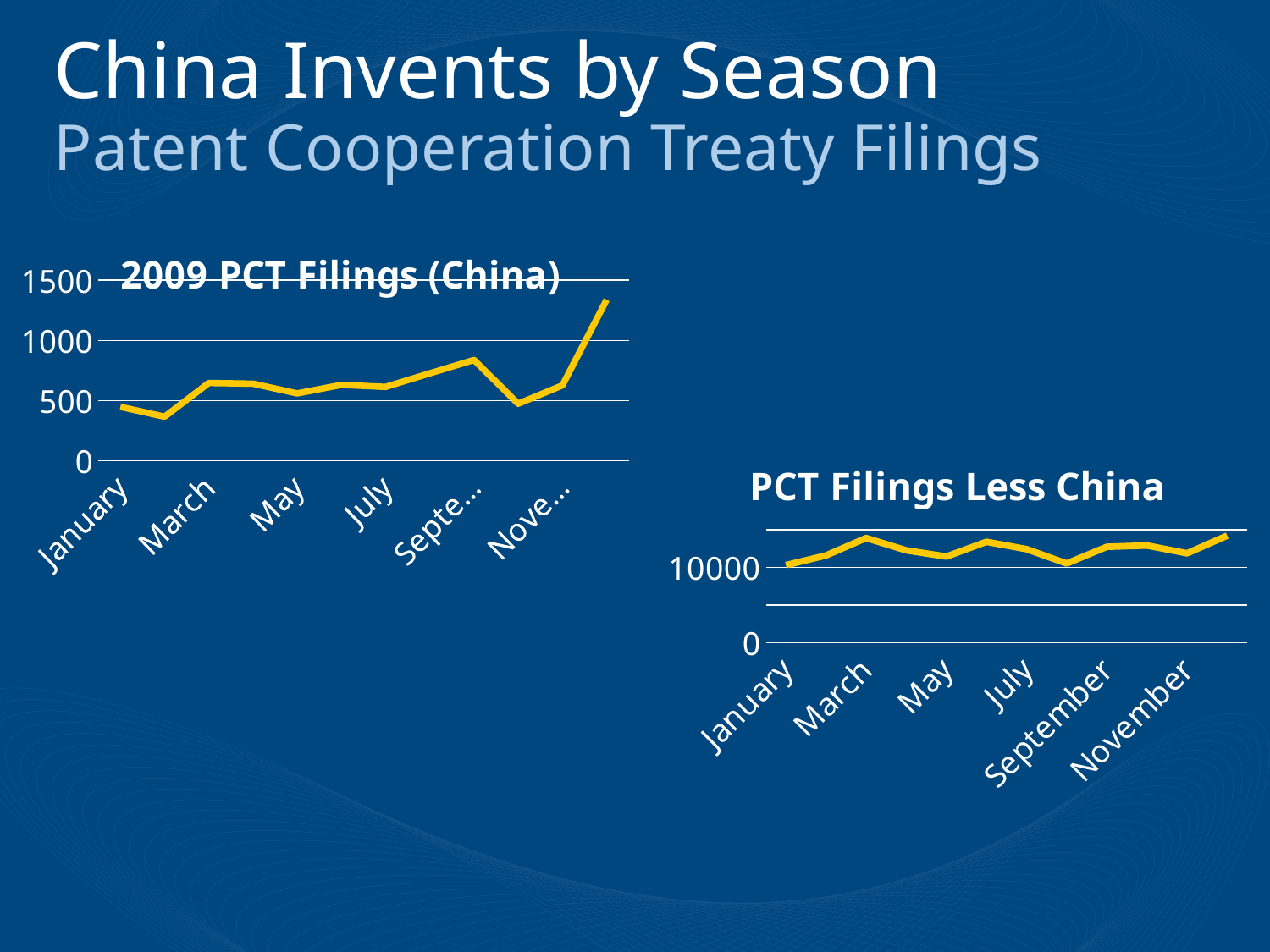
In the 'PCT Filings Less China' chart, is the value for March greater or less than 10000? greater In the '2009 PCT Filings (China)' chart, is the value for December greater or less than 1000? greater In the '2009 PCT Filings (China)' chart, is the value for September greater or less than 1000? less How many data points are plotted in the 'PCT Filings Less China' chart? 12 In the '2009 PCT Filings (China)' chart, which month has the highest value? December What kind of chart is the '2009 PCT Filings (China)' chart? line chart In the 'PCT Filings Less China' chart, which is larger, the value for January or the value for March? March What kind of chart is the 'PCT Filings Less China' chart? line chart In the '2009 PCT Filings (China)' chart, which is larger, the value for January or the value for December? December In the '2009 PCT Filings (China)' chart, do the values generally rise or fall from January to December? rise